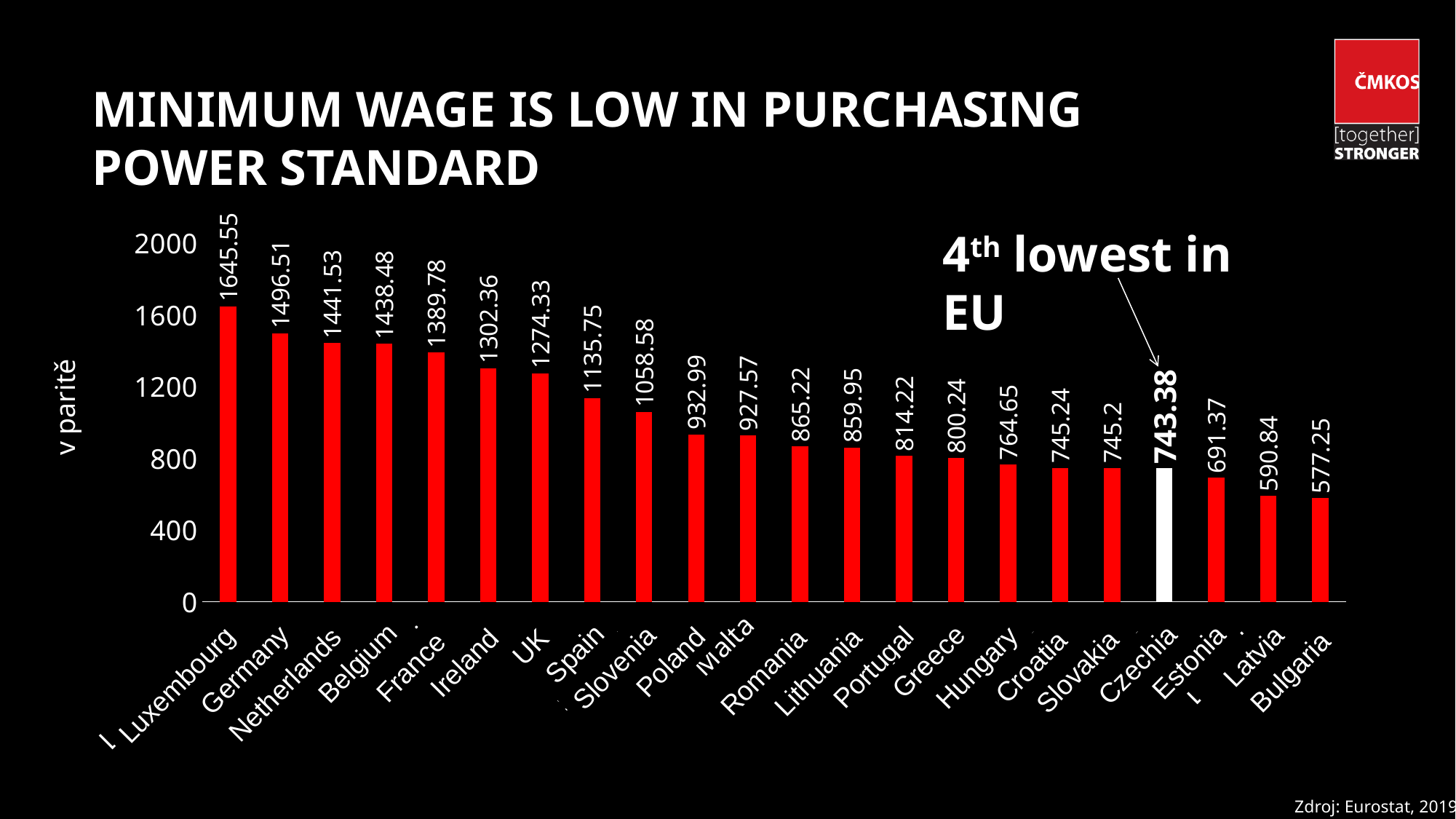
What kind of chart is shown on the slide? Bar chart What is the value for Bulgaria? 577.25 What is the value for Luxembourg? 1645.55 How many countries are shown in the chart? 22 Which country has the highest value? Luxembourg What is the difference between the values for Czechia and Bulgaria? 166.13 Which bar is highlighted in white instead of red? Czechia What is the difference between the values for Luxembourg and Bulgaria? 1068.3 What is the value for Czechia? 743.38 What is the value for Spain? 1135.75 Which country has the lowest value? Bulgaria Which has a larger value, Germany or Ireland? Germany